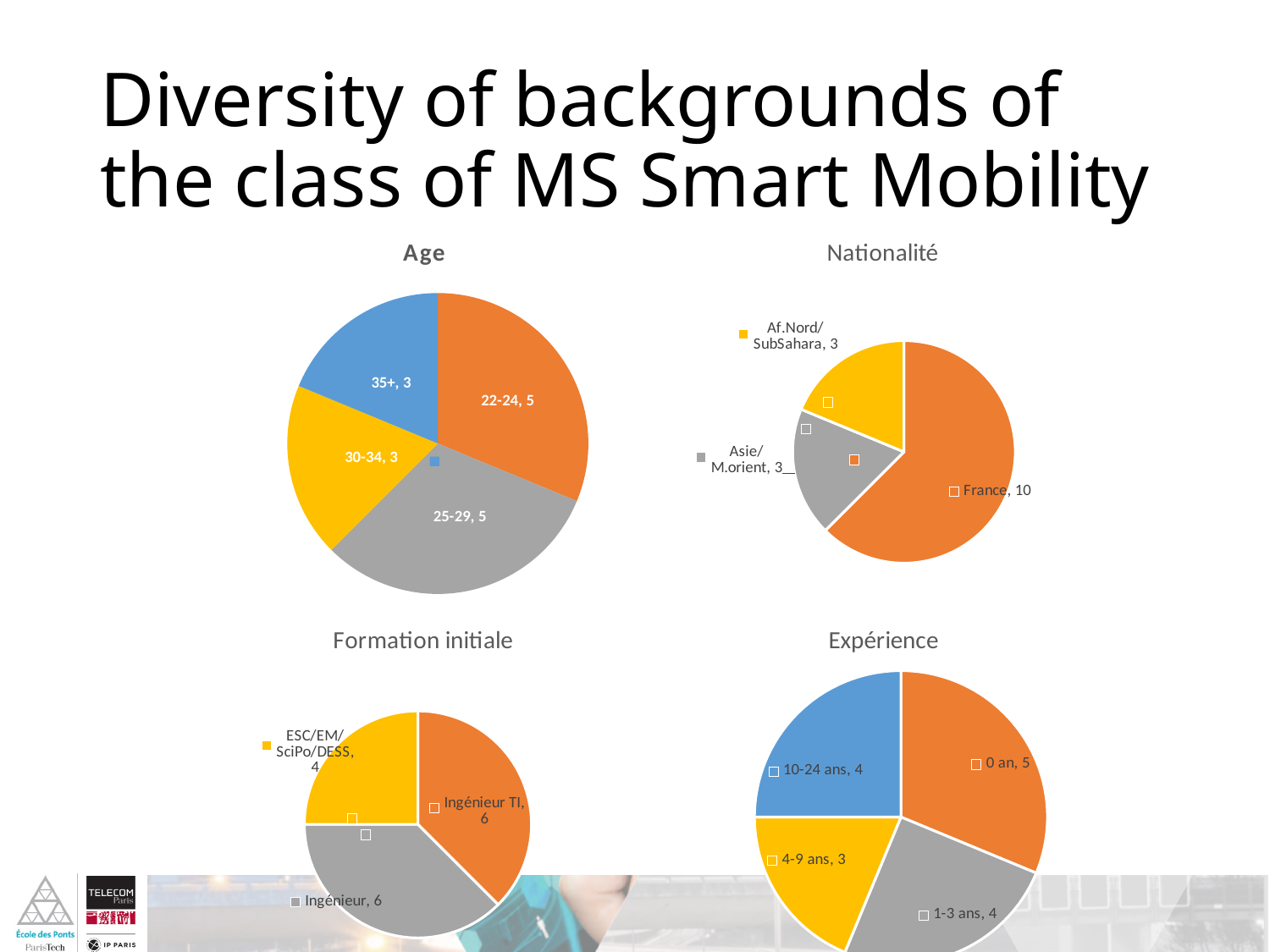
In the Nationalité chart, what is the value for France? 10 How many categories does the Age chart show? 4 In the Age chart, how many students are in the 22-24 category? 5 In the Nationalité chart, which category has the largest slice? France What type of chart is used for Expérience? Pie chart In the Expérience chart, what is the value for 4-9 ans? 3 In the Nationalité chart, what is the difference between France and Asie/M.orient? 7 In the Expérience chart, which category has the smallest slice? 4-9 ans How many categories does the Formation initiale chart show? 3 In the Expérience chart, which is larger: 0 an or 1-3 ans? 0 an In the Formation initiale chart, what is the value for ESC/EM/SciPo/DESS? 4 In the Nationalité chart, what share of the total does France represent? 62.5%